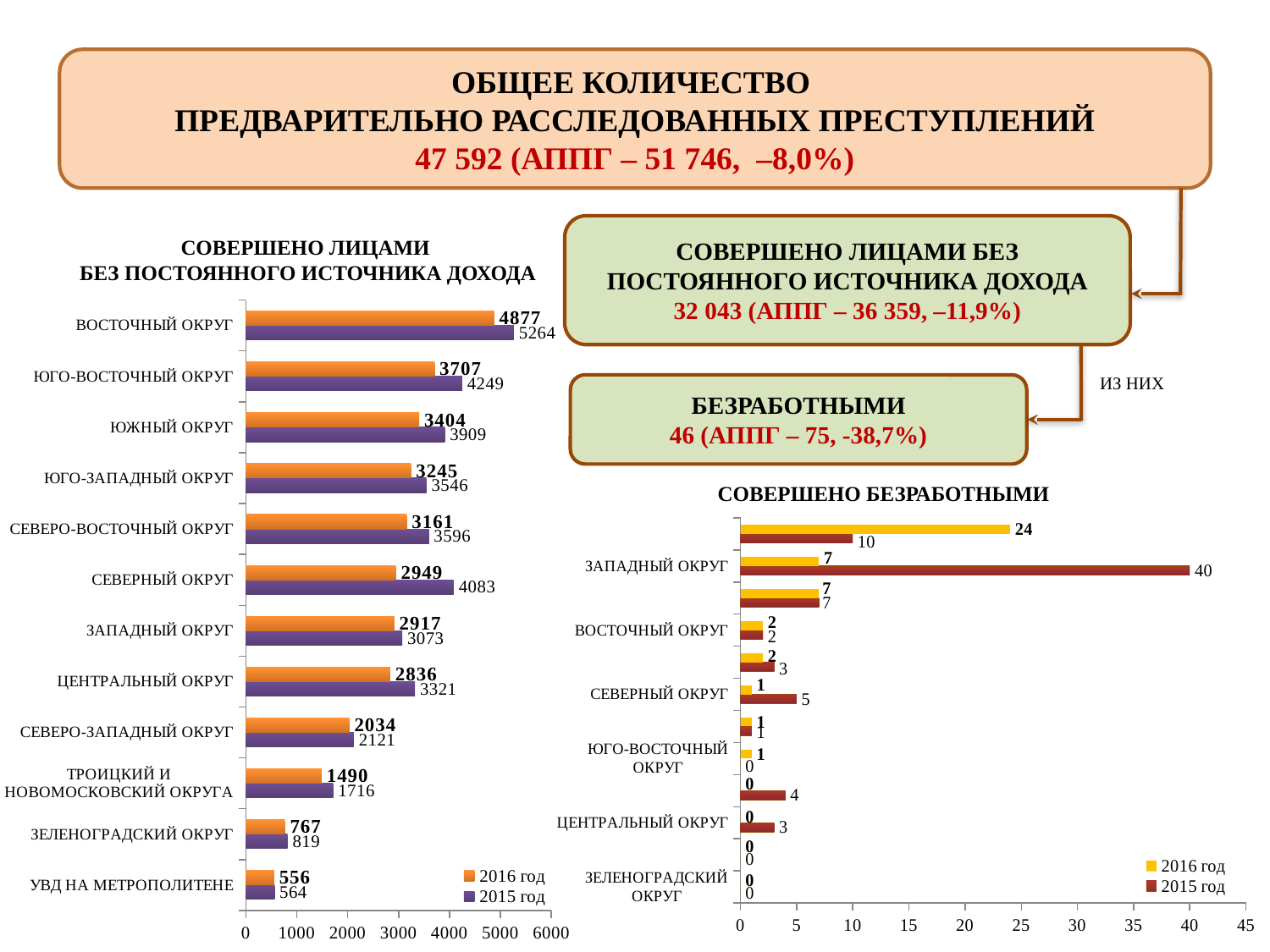
What kind of chart is the one titled 'СОВЕРШЕНО БЕЗРАБОТНЫМИ'? bar chart On the chart titled 'СОВЕРШЕНО ЛИЦАМИ БЕЗ ПОСТОЯННОГО ИСТОЧНИКА ДОХОДА', what is the difference between the 2015 год and 2016 год values for ЦЕНТРАЛЬНЫЙ ОКРУГ? 485 On the chart titled 'СОВЕРШЕНО БЕЗРАБОТНЫМИ', what colour are the bars for 2016 год? yellow On the chart titled 'СОВЕРШЕНО ЛИЦАМИ БЕЗ ПОСТОЯННОГО ИСТОЧНИКА ДОХОДА', which category has the highest value for 2016 год? ВОСТОЧНЫЙ ОКРУГ On the chart titled 'СОВЕРШЕНО ЛИЦАМИ БЕЗ ПОСТОЯННОГО ИСТОЧНИКА ДОХОДА', which category has the lowest value for 2015 год? УВД НА МЕТРОПОЛИТЕНЕ On the chart titled 'СОВЕРШЕНО БЕЗРАБОТНЫМИ', what is the highest value shown for 2015 год? 40 On the chart titled 'СОВЕРШЕНО ЛИЦАМИ БЕЗ ПОСТОЯННОГО ИСТОЧНИКА ДОХОДА', which is larger for ЮЖНЫЙ ОКРУГ: the 2016 год value or the 2015 год value? 2015 год On the chart titled 'СОВЕРШЕНО ЛИЦАМИ БЕЗ ПОСТОЯННОГО ИСТОЧНИКА ДОХОДА', how many series does the legend list? 2 On the chart titled 'СОВЕРШЕНО ЛИЦАМИ БЕЗ ПОСТОЯННОГО ИСТОЧНИКА ДОХОДА', what is the value for СЕВЕРНЫЙ ОКРУГ in 2015 год? 4083 On the chart titled 'СОВЕРШЕНО ЛИЦАМИ БЕЗ ПОСТОЯННОГО ИСТОЧНИКА ДОХОДА', what is the value for ВОСТОЧНЫЙ ОКРУГ in 2016 год? 4877 On the chart titled 'СОВЕРШЕНО БЕЗРАБОТНЫМИ', what is the highest value shown for 2016 год? 24 On the chart titled 'СОВЕРШЕНО ЛИЦАМИ БЕЗ ПОСТОЯННОГО ИСТОЧНИКА ДОХОДА', how many categories are shown? 12